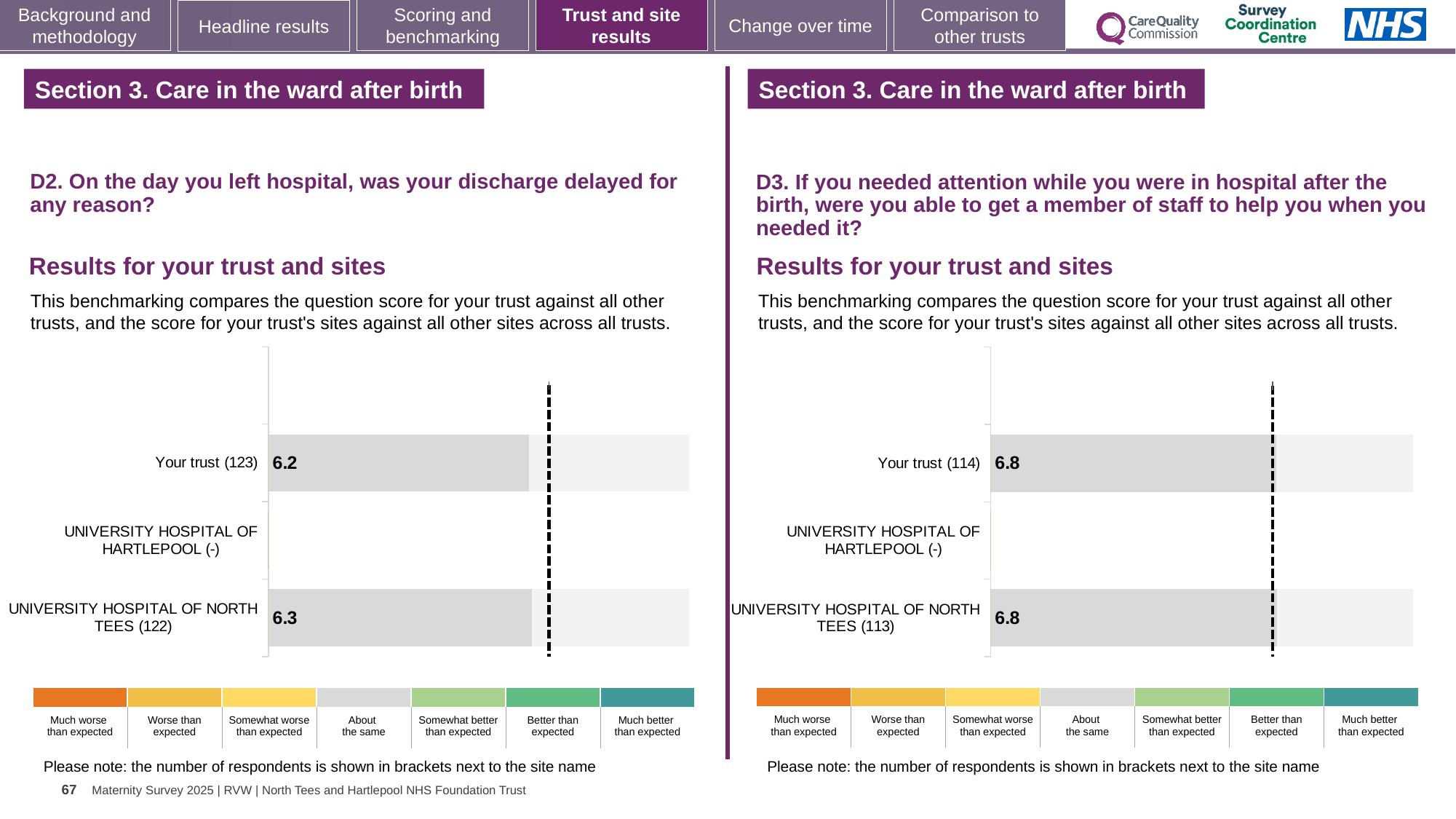
In the D2 chart on the left, which of Your trust (123) or UNIVERSITY HOSPITAL OF NORTH TEES (122) has the higher score? UNIVERSITY HOSPITAL OF NORTH TEES (122) In the D2 chart on the left, how many categories are listed on the vertical axis? 3 In the D3 chart on the right, what is the score for UNIVERSITY HOSPITAL OF NORTH TEES (113)? 6.8 In the D2 chart on the left, what is the difference between the score for UNIVERSITY HOSPITAL OF NORTH TEES (122) and the score for Your trust (123)? 0.1 In the D3 chart on the right, how many respondents are shown in brackets for Your trust? 114 In the D3 chart on the right, what is the difference between the score for Your trust (114) and the score for UNIVERSITY HOSPITAL OF NORTH TEES (113)? 0 In the D3 chart on the right, what is the score for Your trust (114)? 6.8 In the D2 chart on the left, what is the score for UNIVERSITY HOSPITAL OF NORTH TEES (122)? 6.3 In the D3 chart on the right, how many categories are listed on the vertical axis? 3 In the D2 chart on the left, which category has no bar plotted? UNIVERSITY HOSPITAL OF HARTLEPOOL (-) What kind of chart is the D2 chart on the left? Bar chart In the D2 chart on the left, what is the score for Your trust (123)? 6.2